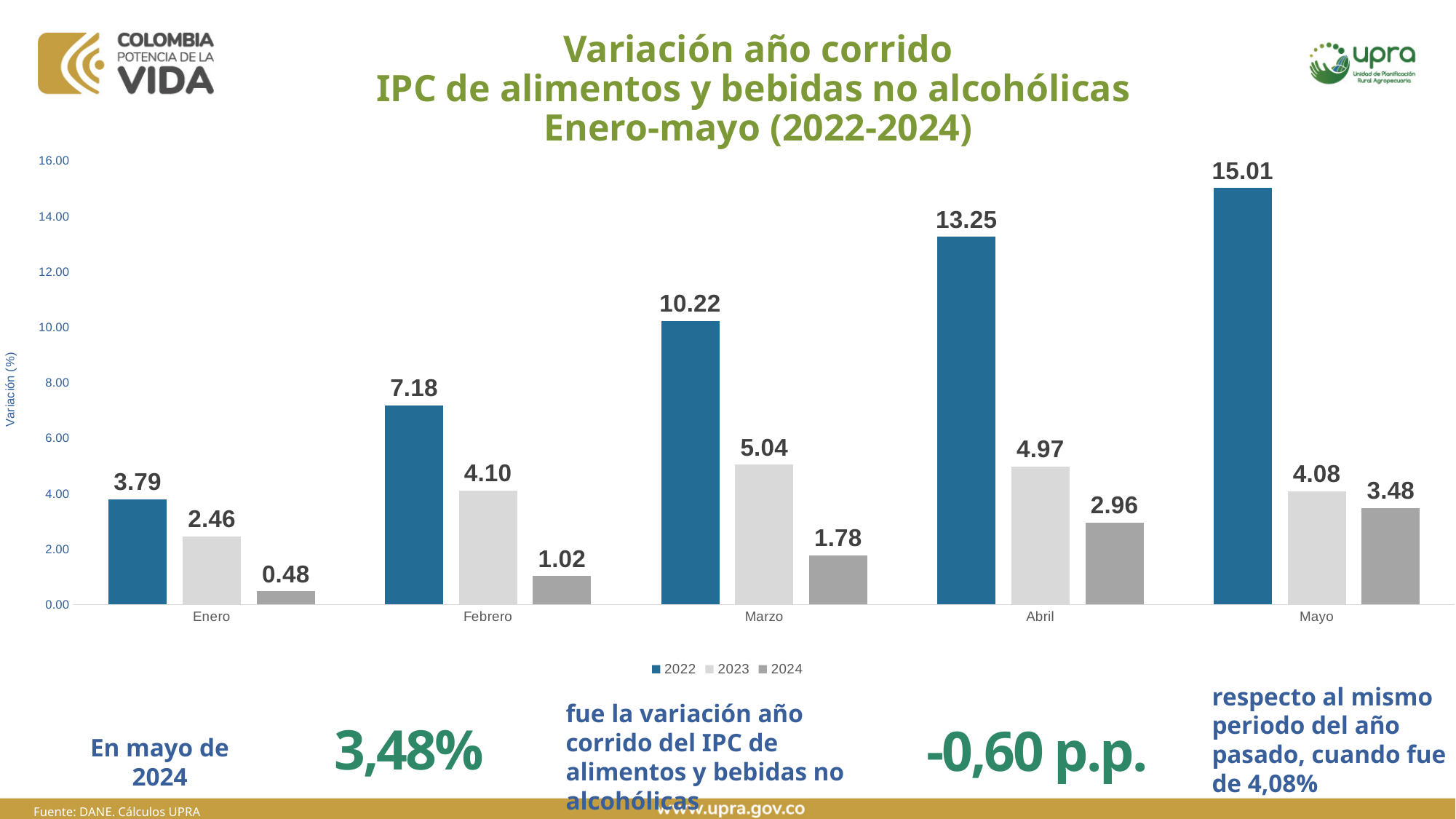
What kind of chart is shown on the slide? bar chart Do the values for the 2022 series rise or fall from Enero to Mayo? rise What is the value for 2022 in Mayo? 15.01 Which is larger in Abril: the 2023 value or the 2024 value? 2023 What is the value for 2023 in Marzo? 5.04 Is the value for 2022 in Marzo greater or less than 10.00? greater Which month has the highest value for the 2022 series? Mayo What is the difference between the 2023 and 2024 values in Mayo? 0.60 Which month has the lowest value for the 2024 series? Enero How many series does the legend list? 3 How many months are shown on the x axis? 5 What is the value for 2024 in Enero? 0.48